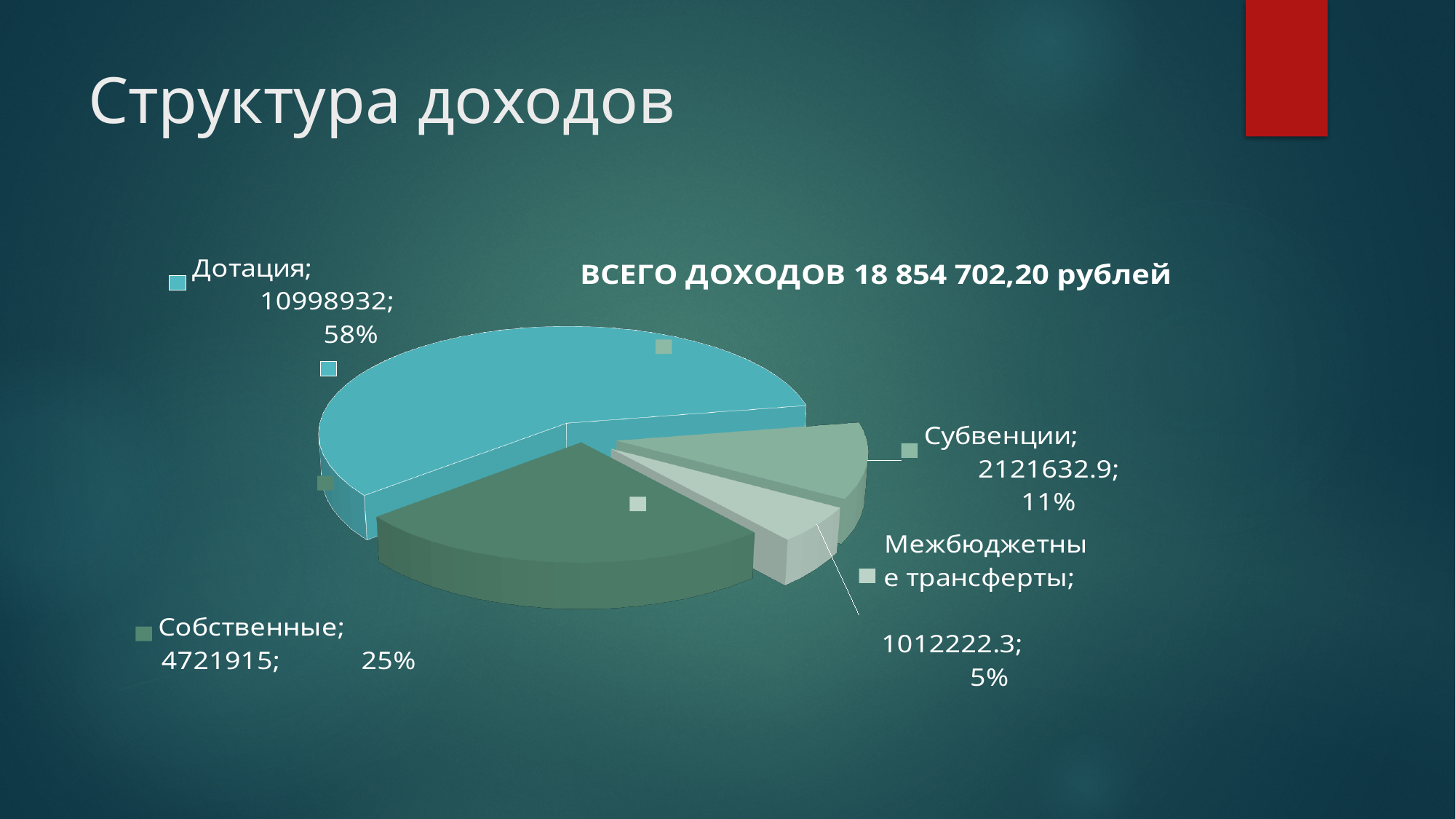
What share of the pie does Дотация represent? 58% Which category has the largest slice? Дотация How many slices does the pie chart have? 4 Which is larger, Субвенции or Собственные? Собственные What is the chart's title? ВСЕГО ДОХОДОВ 18 854 702,20 рублей What is the value shown for Собственные? 4721915 What kind of chart is shown on the slide? pie chart What share of the pie does Собственные represent? 25% What is the value shown for Дотация? 10998932 Which category has the smallest slice? Межбюджетные трансферты What is the value shown for Межбюджетные трансферты? 1012222.3 What is the value shown for Субвенции? 2121632.9